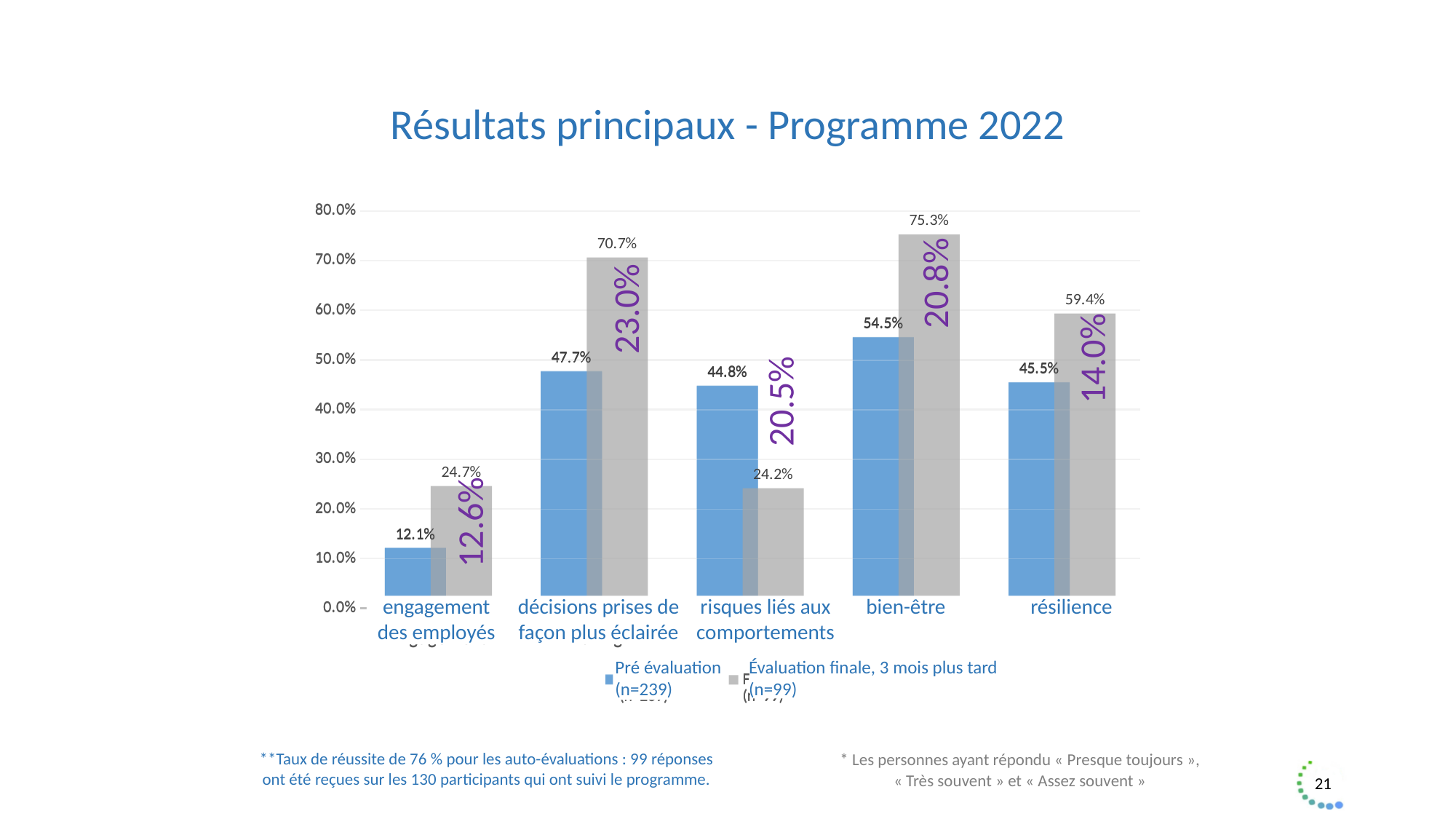
How many series does the legend list? 2 Which is larger for risques liés aux comportements: the Pré évaluation value or the Évaluation finale value? Pré évaluation What type of chart is shown on the slide? bar chart Which category has the lowest Pré évaluation value? engagement des employés What is the difference between the Évaluation finale and Pré évaluation values for décisions prises de façon plus éclairée? 23.0% What is the Évaluation finale value for bien-être? 75.3% What is the title of the chart? Résultats principaux - Programme 2022 Which category has the highest Évaluation finale value? bien-être How many categories are shown on the x axis? 5 What is the Évaluation finale value for risques liés aux comportements? 24.2% What is the Pré évaluation value for engagement des employés? 12.1% What is the Pré évaluation value for résilience? 45.5%